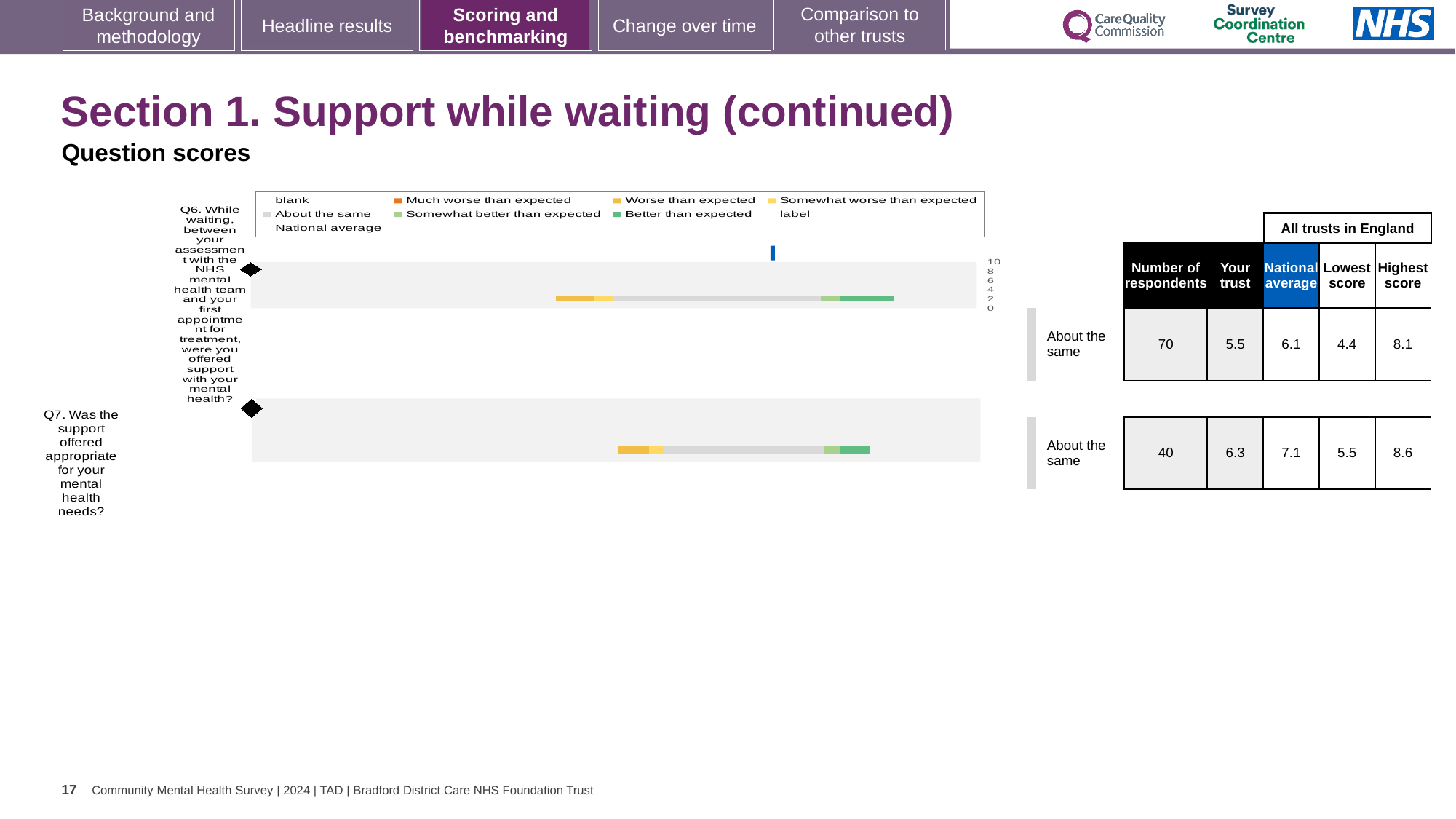
What is the highest score among all trusts in England for Q7? 8.6 What kind of chart is used to show the question scores on this slide? bar chart How many questions are plotted in the question scores chart? 2 What is the lowest score among all trusts in England for Q6? 4.4 What benchmark category is shown for both Q6 and Q7? About the same What is the 'Your trust' score for Q6 (support while waiting between assessment and first appointment)? 5.5 What is the national average score for Q7 (was the support offered appropriate for your mental health needs)? 7.1 What is the difference between the highest and lowest scores for Q7? 3.1 For Q6, which is larger: the 'Your trust' score or the national average? National average What colour represents 'Better than expected' in the chart legend? Green By how much does the national average exceed the 'Your trust' score for Q6? 0.6 How many respondents answered Q6? 70